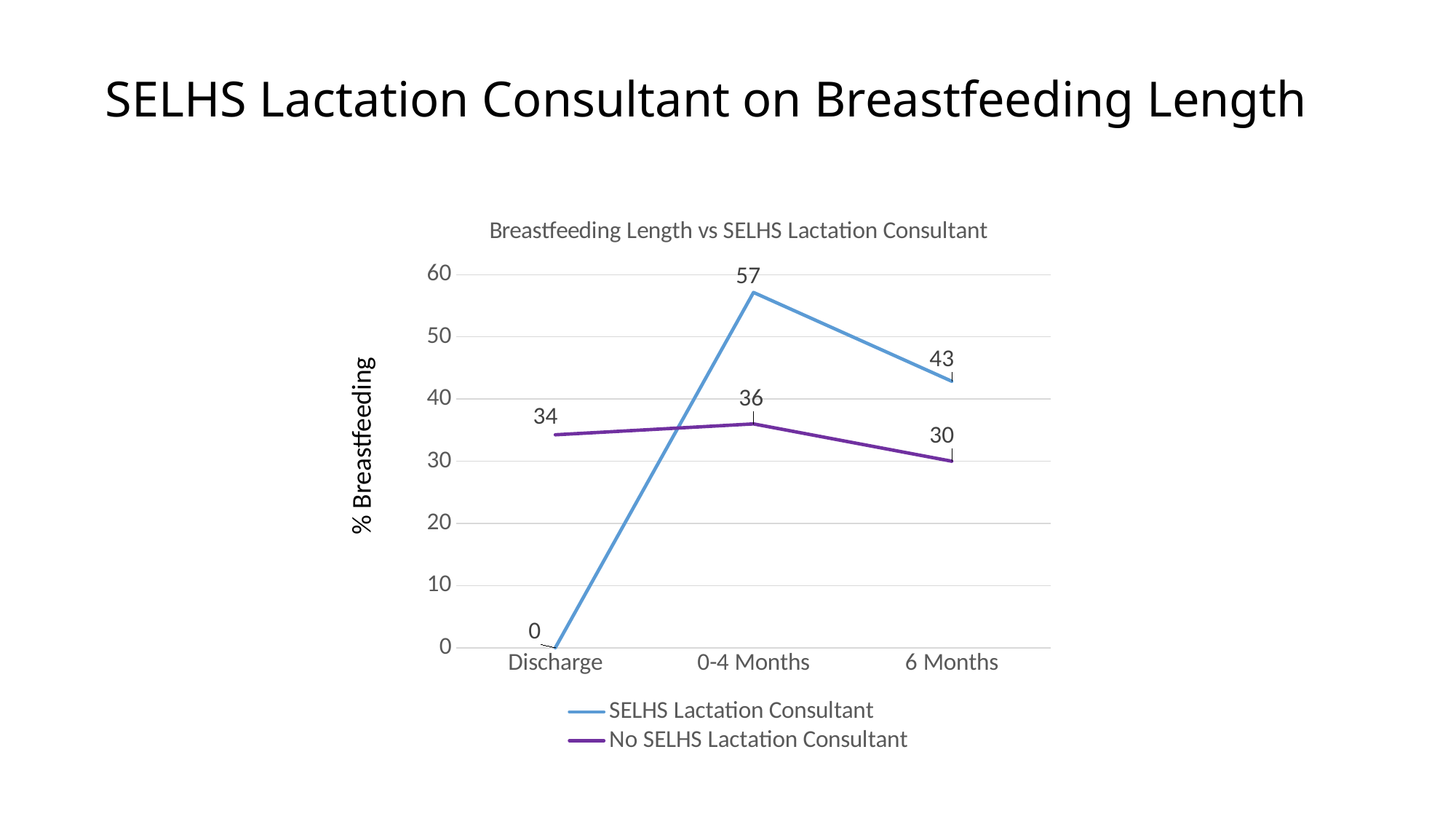
What is the value for No SELHS Lactation Consultant at 6 Months? 30 What is the difference between the SELHS Lactation Consultant and No SELHS Lactation Consultant values at 0-4 Months? 21 At which category does the SELHS Lactation Consultant series reach its highest value? 0-4 Months What kind of chart is shown on the slide? Line chart What is the value for SELHS Lactation Consultant at 0-4 Months? 57 What is the value for SELHS Lactation Consultant at 6 Months? 43 How many categories are shown on the x axis? 3 At Discharge, which series has the larger value: SELHS Lactation Consultant or No SELHS Lactation Consultant? No SELHS Lactation Consultant How many series does the legend list? 2 At which category is the SELHS Lactation Consultant series lowest? Discharge What is the title of the chart? Breastfeeding Length vs SELHS Lactation Consultant What is the value for No SELHS Lactation Consultant at Discharge? 34